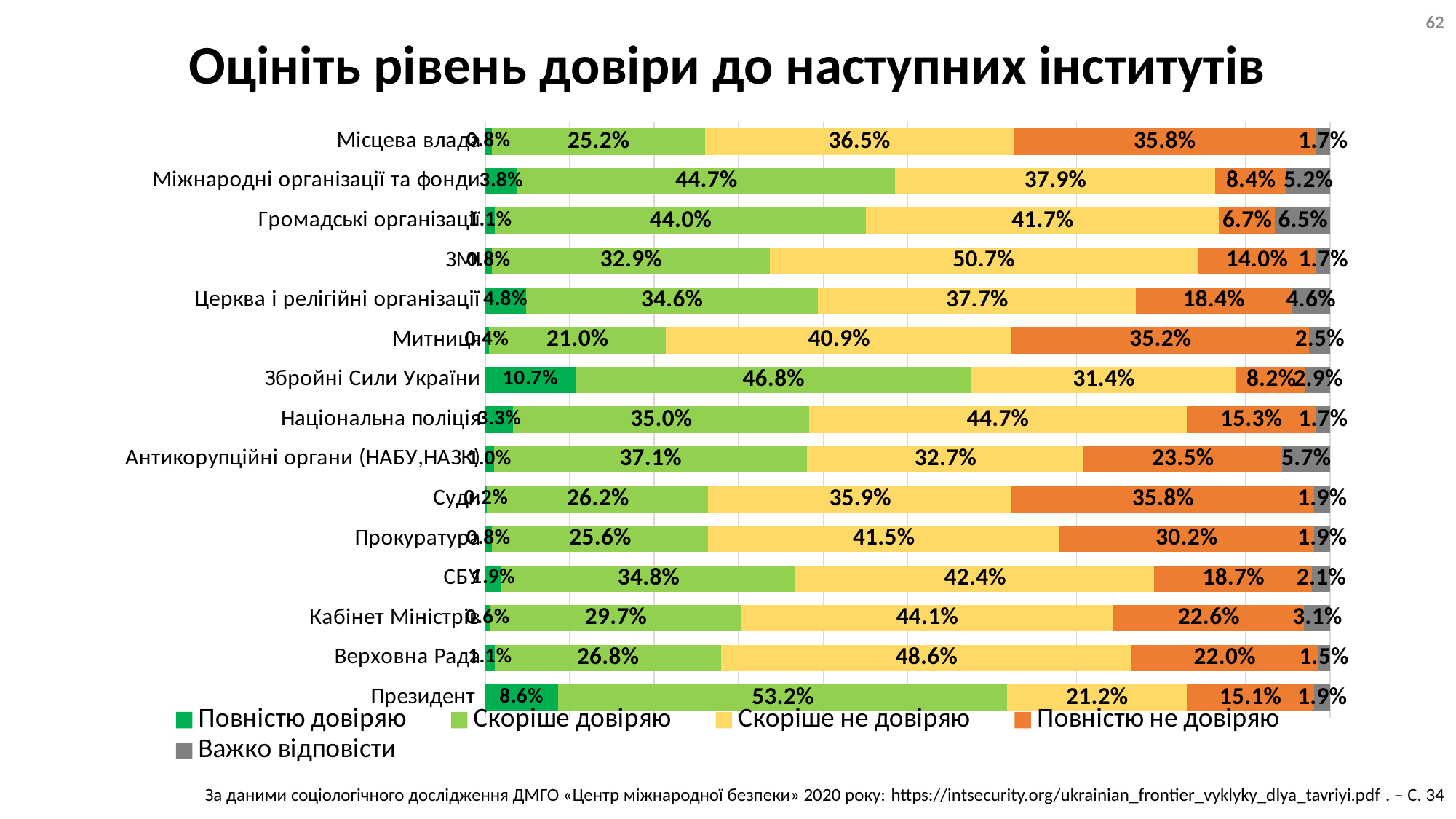
How many institutions (categories) are shown in the chart? 15 What type of chart is shown on the slide? stacked bar chart Which institution has the lowest 'Повністю не довіряю' value? Громадські організації Which is larger: the 'Скоріше не довіряю' value for Верховна Рада or for Кабінет Міністрів? Верховна Рада What is the difference between the 'Повністю не довіряю' values for Суди and Прокуратура? 5.6% What is the 'Повністю не довіряю' value for Митниця? 35.2% Which institution has the highest 'Скоріше довіряю' value? Президент How many series does the legend list? 5 What is the 'Повністю довіряю' value for Збройні Сили України? 10.7% What is the 'Скоріше не довіряю' value for ЗМІ? 50.7% What is the 'Скоріше довіряю' value for Президент? 53.2% What is the 'Важко відповісти' value for Громадські організації? 6.5%